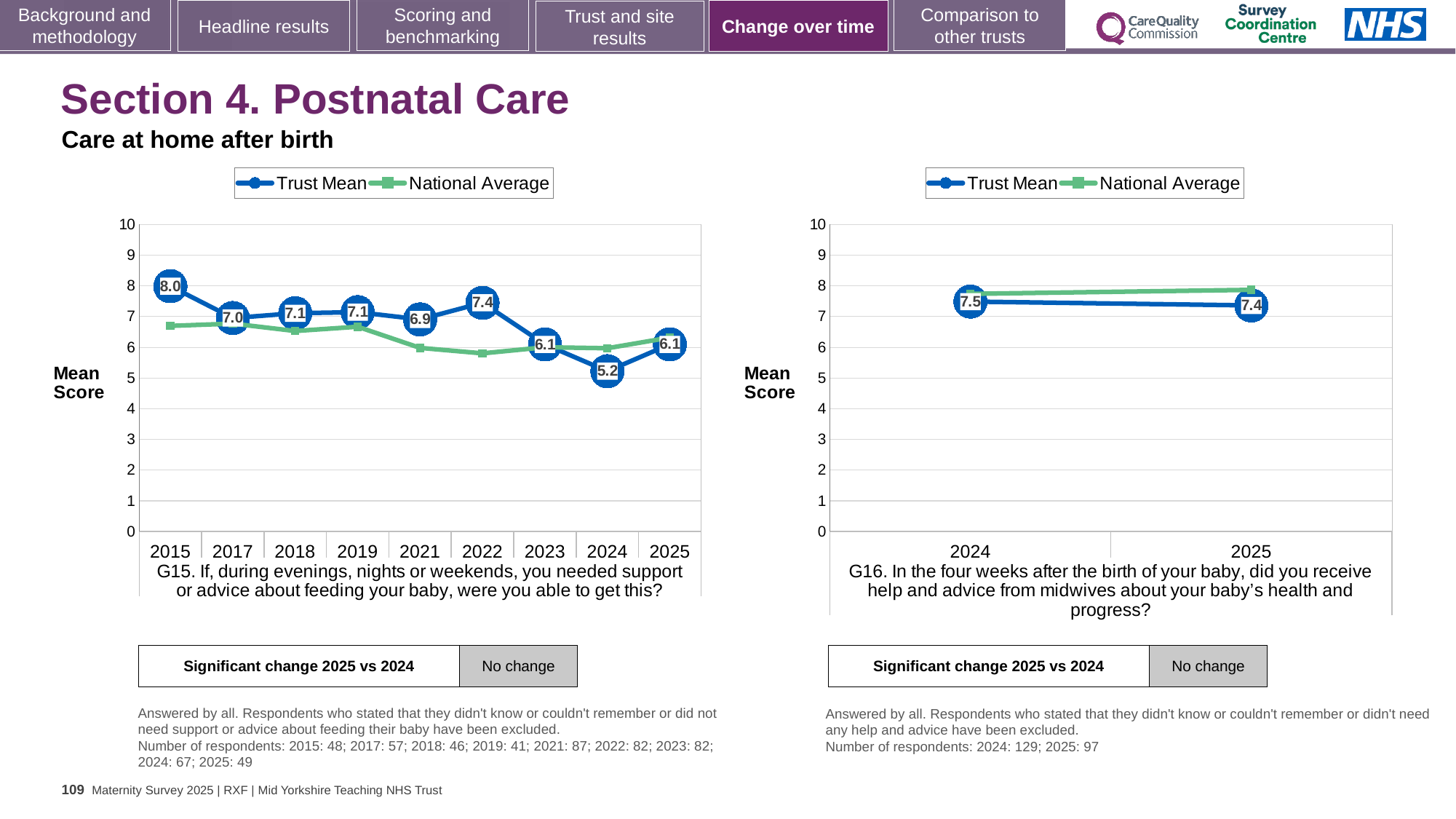
In the G15 chart on the left, is the National Average for 2015 greater or less than 7? less In the G15 chart on the left, is the Trust Mean higher in 2022 or in 2021? 2022 How many series does the legend of the G16 chart on the right list? 2 In the G15 chart on the left, what is the Trust Mean for 2015? 8.0 In the G15 chart on the left, which year has the lowest Trust Mean? 2024 In the G16 chart on the right, does the Trust Mean rise or fall from 2024 to 2025? Fall In the G15 chart on the left, which year has the highest Trust Mean? 2015 What kind of chart is the G16 chart on the right? Line chart In the G15 chart on the left, what is the difference between the Trust Mean for 2022 and the Trust Mean for 2023? 1.3 In the G16 chart on the right, what is the Trust Mean for 2025? 7.4 How many years are shown on the x axis of the G15 chart on the left? 9 In the G15 chart on the left, what is the Trust Mean for 2024? 5.2